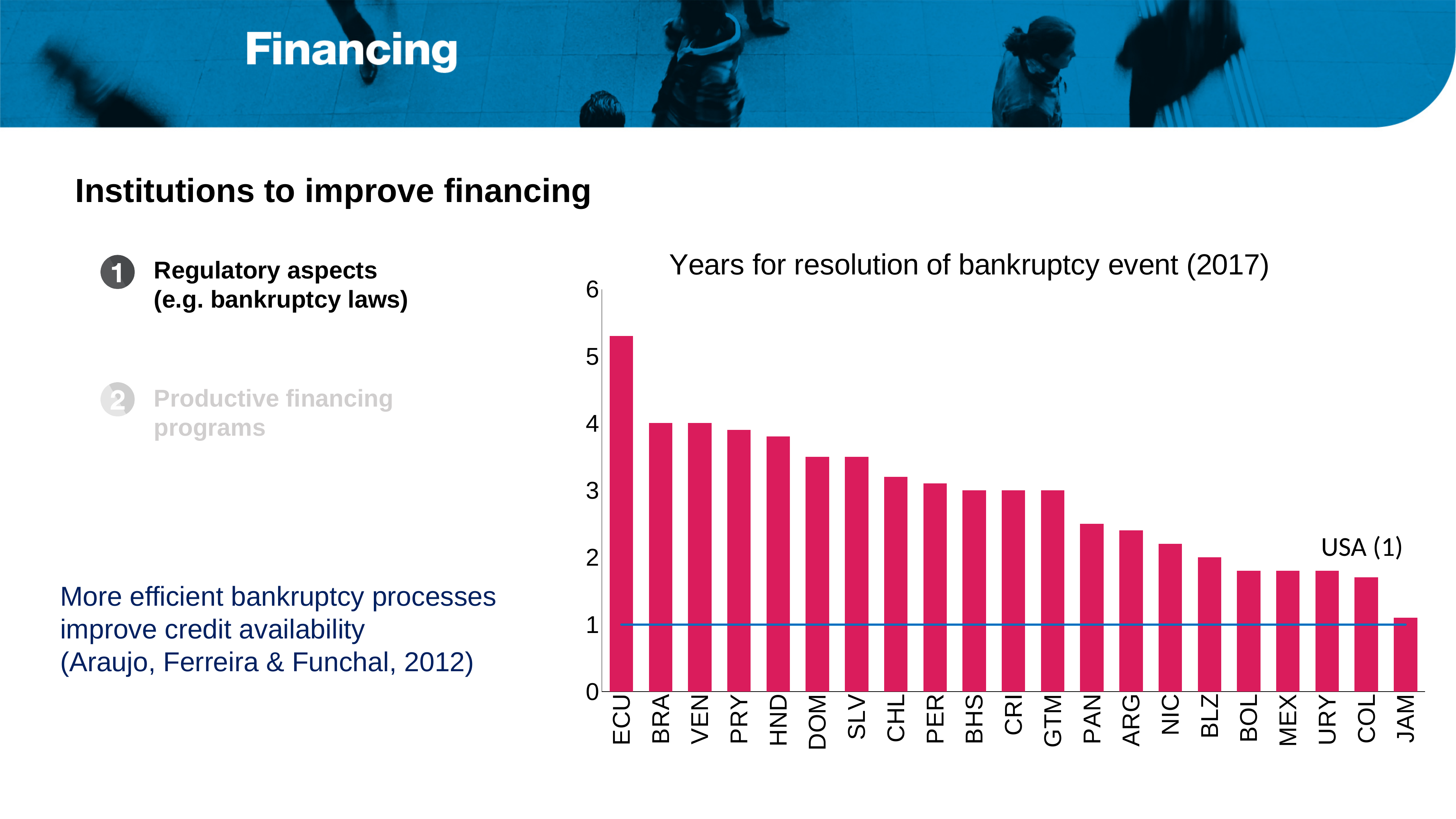
Which country has the highest number of years for resolution of a bankruptcy event? ECU Which has a larger value, DOM or BLZ? DOM Is the value for ECU greater or less than 5? greater Which has a larger value, ECU or BRA? ECU Which country has the lowest number of years for resolution of a bankruptcy event? JAM How many countries are shown on the x axis of the chart? 21 What is the title of the chart? Years for resolution of bankruptcy event (2017) Do the bar values rise or fall from left to right along the x axis? fall Is the value for PAN greater or less than 3? less What value is shown for the USA reference line? 1 What type of chart is shown on the slide? bar chart Is the value for COL greater or less than 2? less